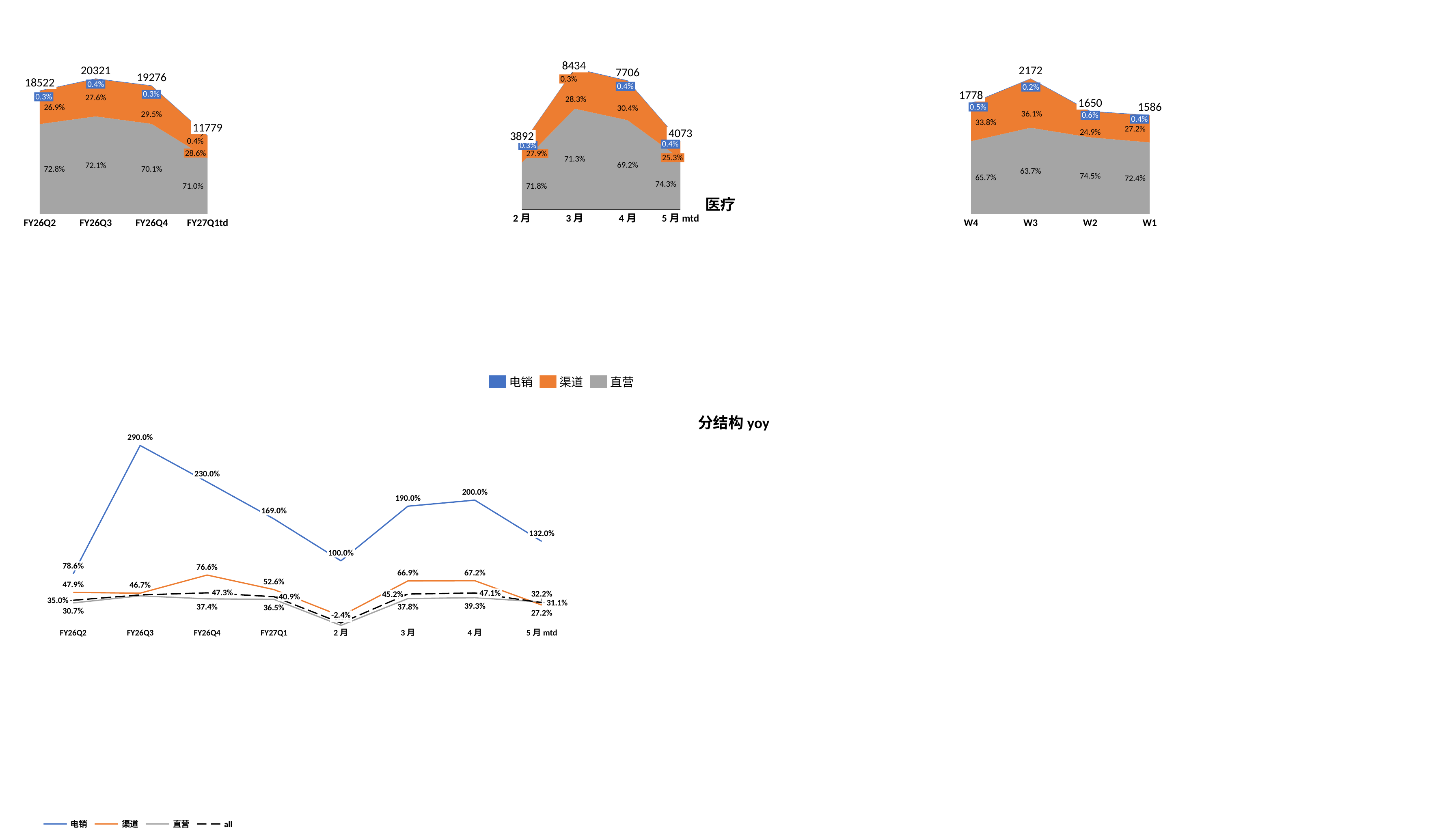
In the bottom chart titled 分结构 yoy, how many series does the legend list? 4 In the top-right chart (W4 to W1), which week has the highest total value? W3 In the bottom chart titled 分结构 yoy, what is the 电销 value for FY26Q3? 290.0% In the top-middle chart (2月 to 5月 mtd), what is the 渠道 share for 4月? 30.4% In the top-left chart (FY26Q2 to FY27Q1td), what is the total value shown for FY26Q3? 20321 What kind of chart is the bottom chart titled 分结构 yoy? line chart In the top-right chart (W4 to W1), what is the 直营 share for W2? 74.5% In the top-left chart (FY26Q2 to FY27Q1td), which period has the lowest total value? FY27Q1td In the top-middle chart (2月 to 5月 mtd), what is the difference between the totals for 3月 and 4月? 728 In the top-left chart (FY26Q2 to FY27Q1td), what is the 直营 share for FY26Q4? 70.1% In the top-middle chart (2月 to 5月 mtd), what is the total value shown for 3月? 8434 In the top-right chart (W4 to W1), which is larger, the 渠道 share for W3 or for W2? W3